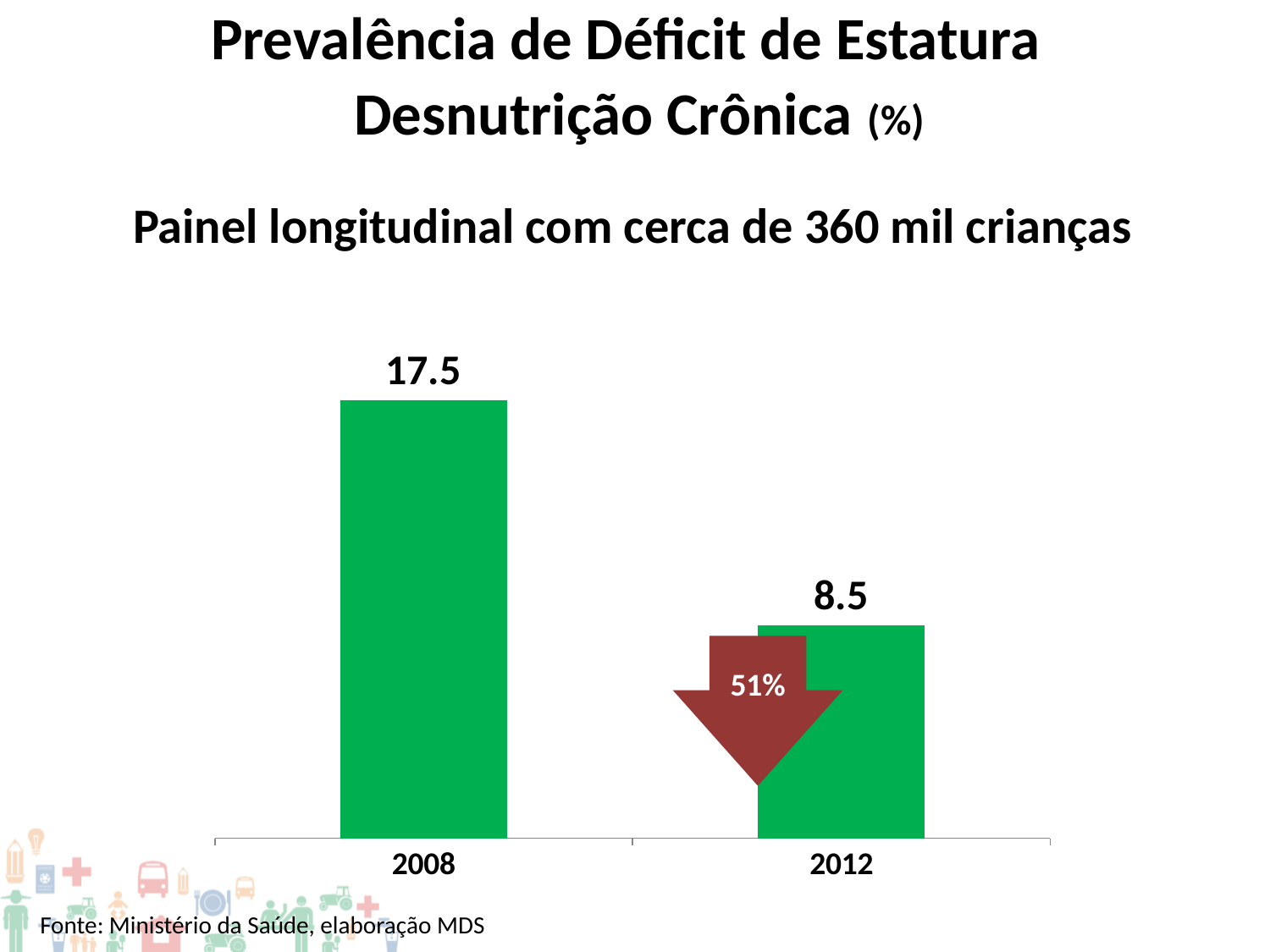
What kind of chart is shown on the slide? bar chart Which year has the lowest value? 2012 Which year has the highest value? 2008 Which is larger, the value for 2008 or the value for 2012? 2008 What percentage reduction is shown in the red arrow on the chart? 51% What is the difference between the values for 2008 and 2012? 9 Do the values rise or fall from 2008 to 2012? fall What is the value for 2008? 17.5 What colour are the bars in the chart? green How many categories are shown on the x axis? 2 What is the value for 2012? 8.5